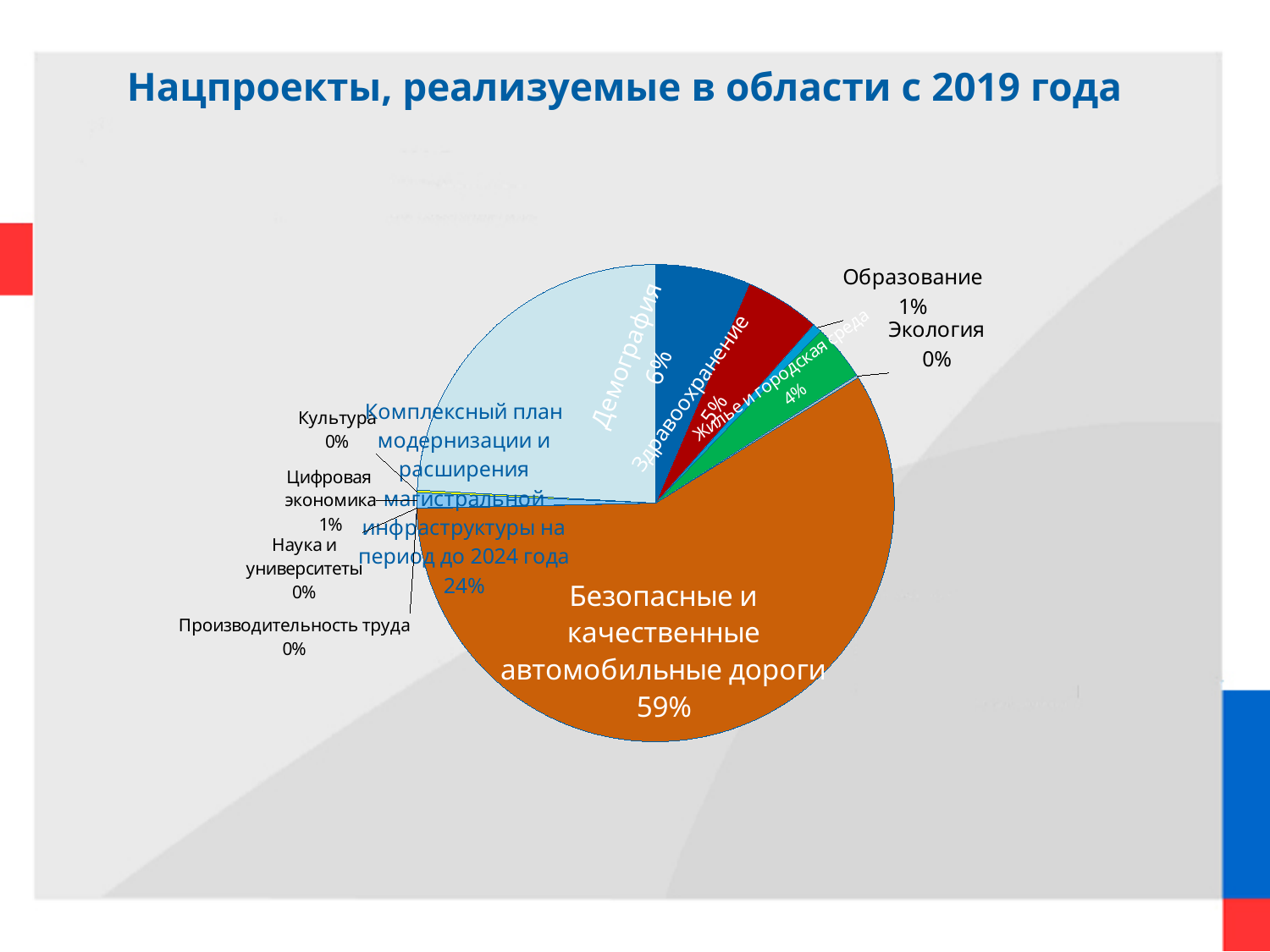
What is the value shown for Демография? 6% Which category has the largest share of the pie? Безопасные и качественные автомобильные дороги What is the value shown for Жилье и городская среда? 4% What share of the pie does Безопасные и качественные автомобильные дороги have? 59% What is the value shown for Образование? 1% What is the value shown for Цифровая экономика? 1% What is the title of the chart? Нацпроекты, реализуемые в области с 2019 года What is the value shown for Здравоохранение? 5% What kind of chart is shown on the slide? pie chart Which is larger, the share for Демография or the share for Жилье и городская среда? Демография What share of the pie does Комплексный план модернизации и расширения магистральной инфраструктуры на период до 2024 года have? 24% What is the difference in percentage points between Безопасные и качественные автомобильные дороги and Комплексный план модернизации и расширения магистральной инфраструктуры на период до 2024 года? 35